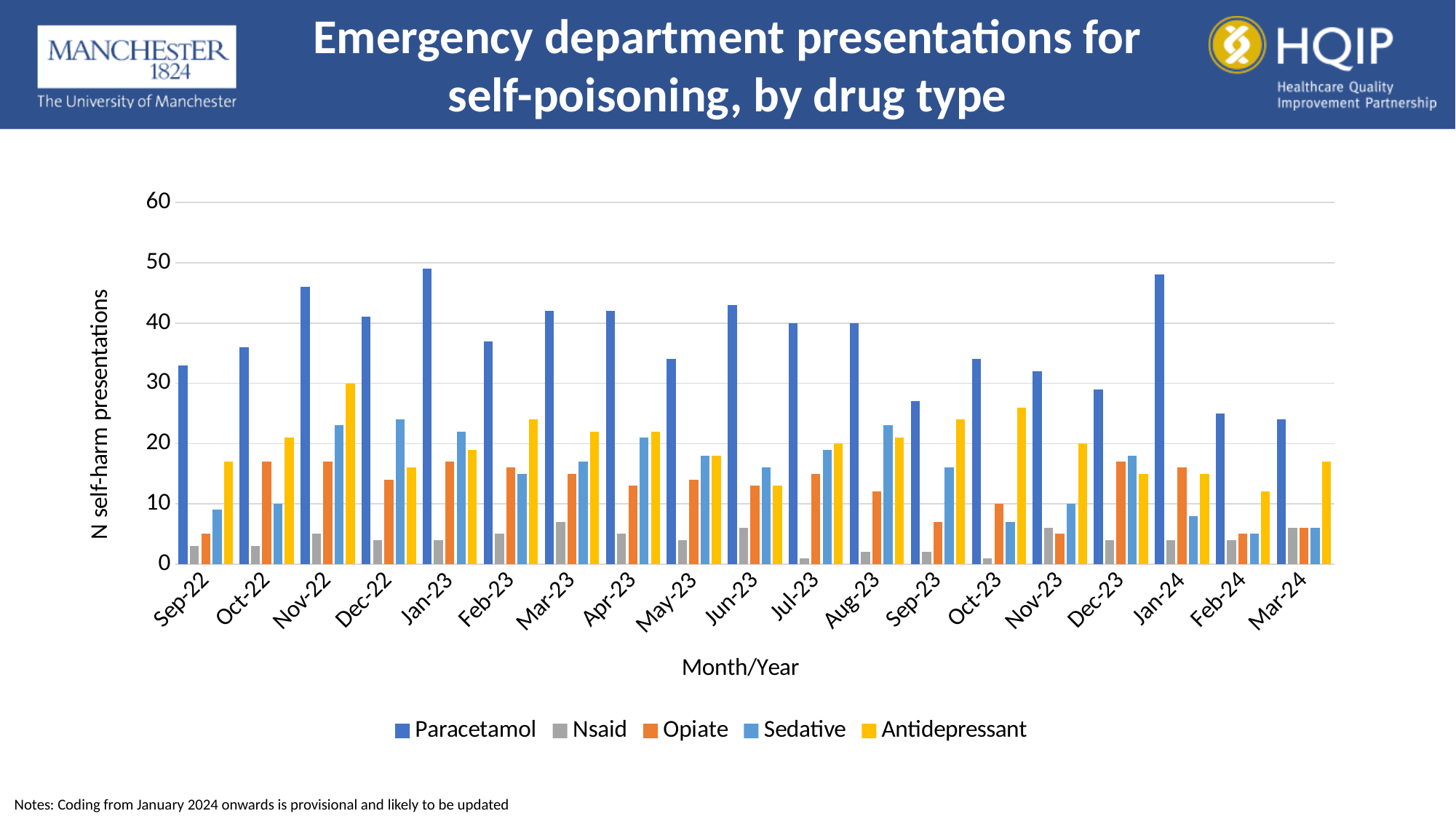
What kind of chart is shown on the slide? Bar chart What is the title of the y axis? N self-harm presentations How many months are shown along the x axis? 19 In Sep-22, which is larger: the Paracetamol value or the Antidepressant value? Paracetamol Is the Antidepressant value for Oct-23 greater or less than 20? greater Is the Paracetamol value for Mar-24 greater or less than 30? less Which colour represents Antidepressant in the legend? Yellow Is the Opiate value for Oct-22 greater or less than 10? greater In Oct-23, which is larger: the Antidepressant value or the Sedative value? Antidepressant How many series does the legend list? 5